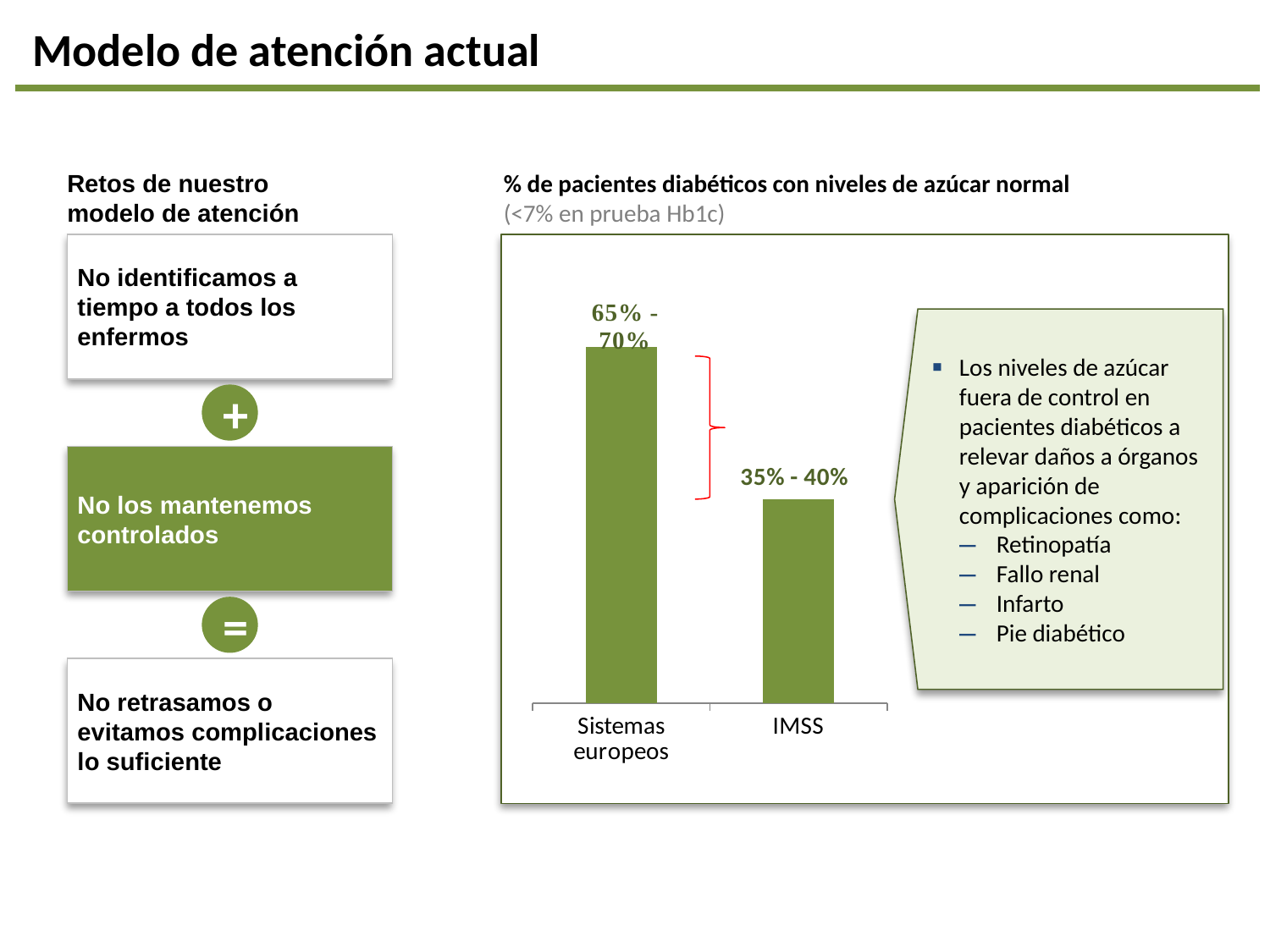
What value is shown for IMSS? 35% - 40% Which category has the lowest value? IMSS What kind of chart is shown on the slide? Bar chart How many categories are plotted in the chart? 2 Do the values rise or fall from left to right along the x axis? Fall What value is shown for Sistemas europeos? 65% - 70% What is the title of the chart? % de pacientes diabéticos con niveles de azúcar normal Which category has the highest value? Sistemas europeos Which is larger, the value for Sistemas europeos or the value for IMSS? Sistemas europeos What threshold is given in the chart's subtitle for the Hb1c test? <7% en prueba Hb1c